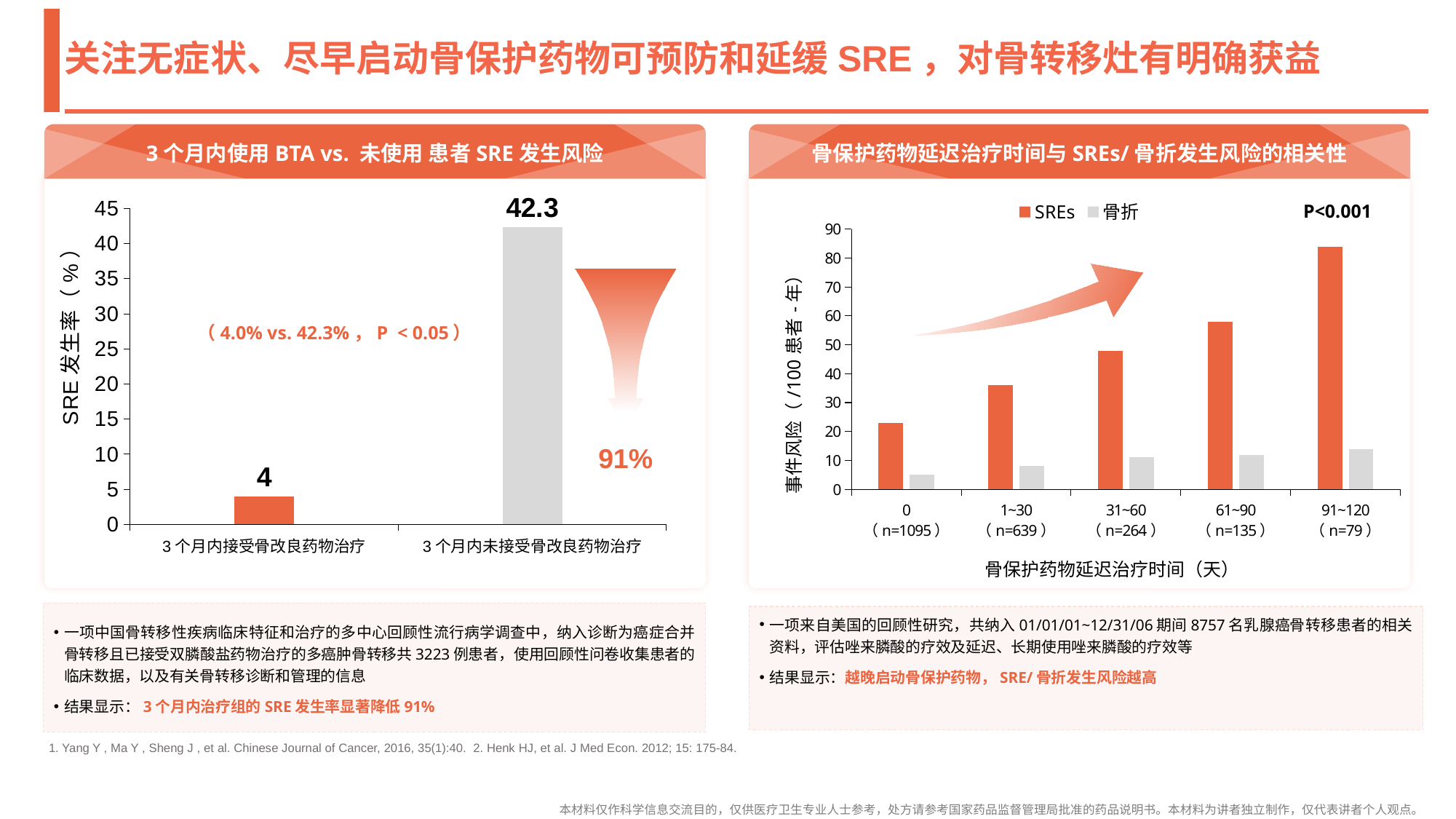
In the left chart, what is the difference between the SRE rates of the untreated and treated groups? 38.3 In the right chart, is the SREs value for 91~120 (n=79) greater or less than 80? greater In the right chart, which delay-time category has the highest SREs value? 91~120 (n=79) What type of chart is the left chart? Bar chart In the right chart, how many delay-time categories are shown on the x axis? 5 In the right chart, is the 骨折 value for 0 (n=1095) greater or less than 10? less In the right chart (骨保护药物延迟治疗时间与SREs/骨折发生风险的相关性), how many series does the legend list? 2 In the left chart, how many bars are plotted? 2 In the left chart (3个月内使用BTA vs. 未使用 患者SRE发生风险), what is the SRE incidence rate for 3个月内接受骨改良药物治疗? 4 In the right chart, do the SREs values rise or fall as the delay time increases? Rise In the left chart, what is the SRE incidence rate for 3个月内未接受骨改良药物治疗? 42.3 In the left chart, which group has the higher SRE incidence rate? 3个月内未接受骨改良药物治疗